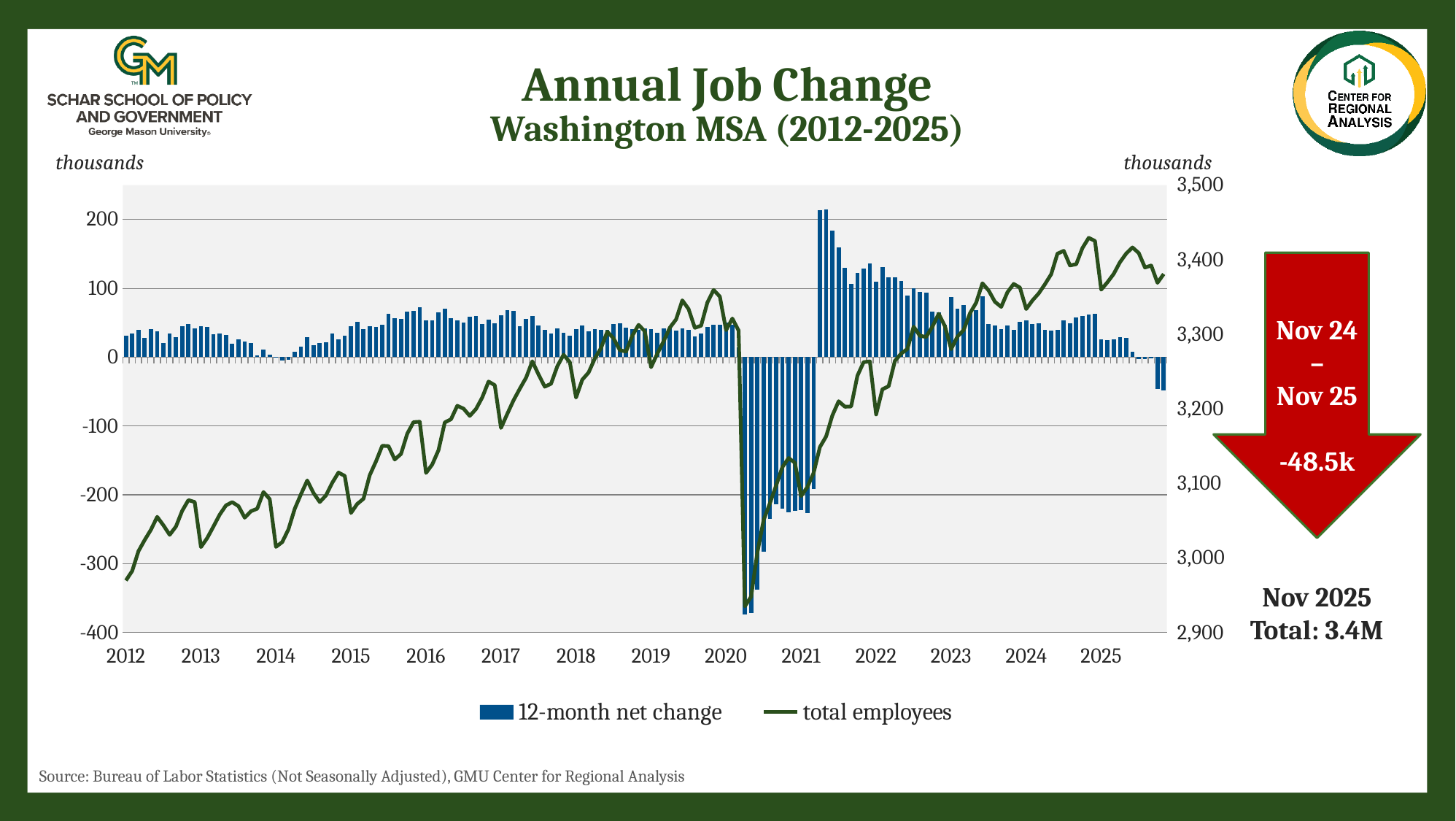
Is the lowest 12-month net change bar in 2020 greater or less than -300? less What is the total employment for Nov 2025 stated on the slide? 3.4M Is the total employees value at the start of 2012 greater or less than 3,100? less In which year do the 12-month net change bars reach their highest value? 2021 What units are shown on the chart's vertical axes? thousands Does the total employees line generally rise or fall from 2012 to 2019? rise According to the red arrow callout, what was the job change from Nov 24 to Nov 25? -48.5k Is the highest 12-month net change bar in 2021 greater or less than 200? greater How many series does the chart legend list? 2 What kind of chart is shown on the slide? A combined bar and line chart In which year do the 12-month net change bars reach their lowest value? 2020 What are the two series named in the chart legend? 12-month net change and total employees